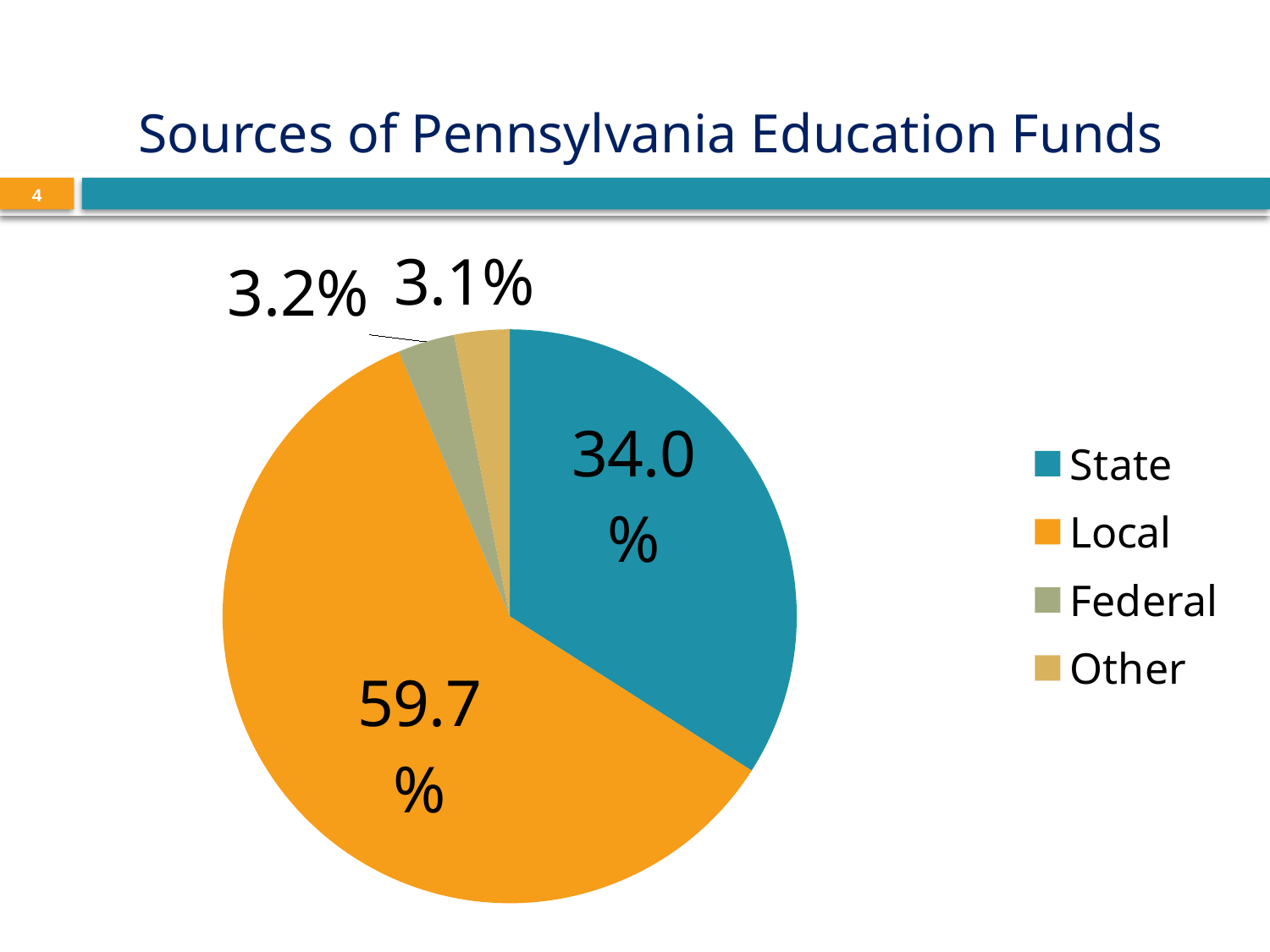
What percentage of Pennsylvania education funds comes from Local sources? 59.7% How many percentage points larger is the Local share than the State share? 25.7 What kind of chart is shown on the slide? pie chart What share of the pie does the State slice represent? 34.0% Which is larger, the State share or the Local share? Local What percentage of Pennsylvania education funds comes from the State? 34.0% How many entries does the legend list? 4 What is the title of the chart? Sources of Pennsylvania Education Funds How many slices does the pie chart have? 4 Which colour represents Local in the pie chart? orange Which source provides the largest share of Pennsylvania education funds? Local What percentage of Pennsylvania education funds comes from Federal sources? 3.2%